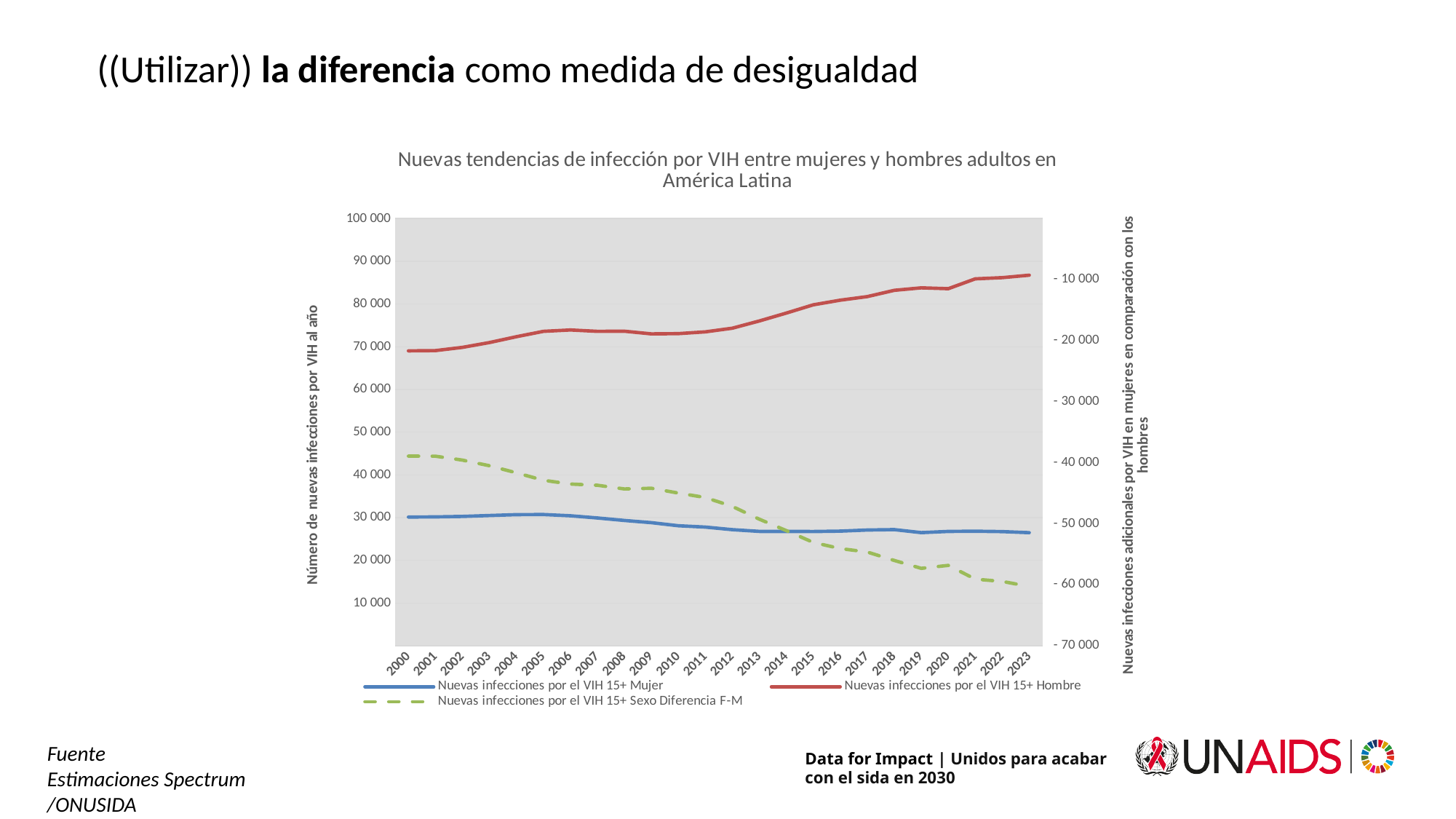
How many years are plotted along the x axis? 24 Is the value for 'Nuevas infecciones por el VIH 15+ Hombre' in 2023 greater or less than 80 000? greater Does the line for 'Nuevas infecciones por el VIH 15+ Hombre' rise or fall from 2000 to 2023? rise Is the value for 'Nuevas infecciones por el VIH 15+ Mujer' in 2023 greater or less than 30 000? less In 2023, which is larger: new HIV infections among 'Hombre' or among 'Mujer'? Hombre Is the value for 'Nuevas infecciones por el VIH 15+ Mujer' in 2000 greater or less than 40 000? less Does the line for 'Nuevas infecciones por el VIH 15+ Mujer' rise or fall from 2000 to 2023? fall What is the title of the chart? Nuevas tendencias de infección por VIH entre mujeres y hombres adultos en América Latina What kind of chart is shown on the slide? line chart What is the first year shown on the x axis? 2000 How many series does the legend list? 3